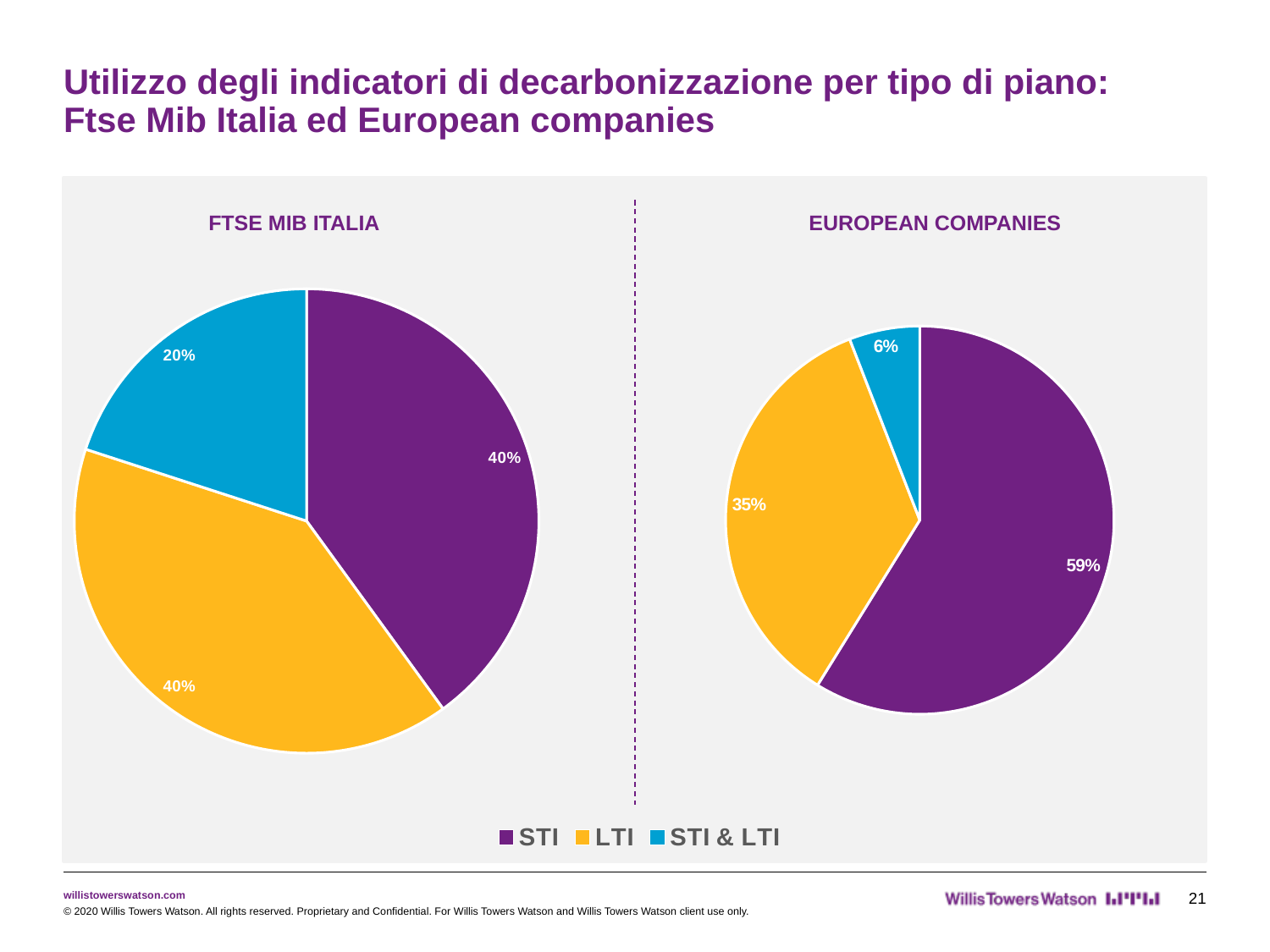
In the FTSE MIB ITALIA chart, what share does STI & LTI have? 20% In the EUROPEAN COMPANIES chart, what share does STI & LTI have? 6% How many entries does the shared legend list? 3 In the EUROPEAN COMPANIES chart, which category has the largest slice? STI What type of chart is used for EUROPEAN COMPANIES? Pie chart In the FTSE MIB ITALIA chart, what share does STI have? 40% In the EUROPEAN COMPANIES chart, what share does LTI have? 35% Is the STI share larger in the FTSE MIB ITALIA chart or in the EUROPEAN COMPANIES chart? EUROPEAN COMPANIES In the FTSE MIB ITALIA chart, which category has the smallest slice? STI & LTI In the EUROPEAN COMPANIES chart, what is the difference between the STI and LTI shares? 24% How many slices does the FTSE MIB ITALIA pie chart have? 3 In the EUROPEAN COMPANIES chart, what share does STI have? 59%